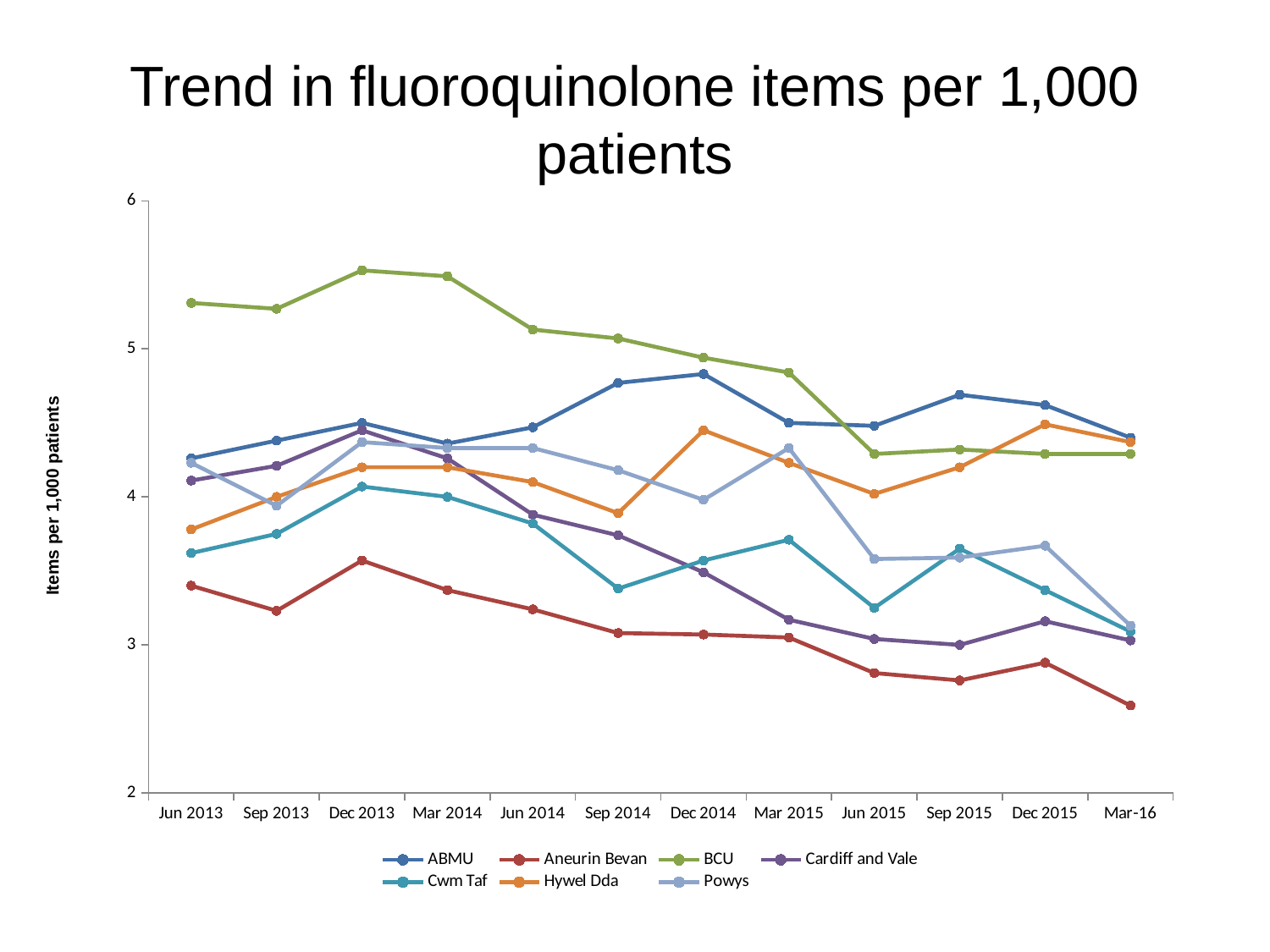
Does the BCU series rise or fall overall from Jun 2013 to Mar-16? fall How many time points are shown along the x axis? 12 How many series does the legend list? 7 Which series has the lowest value at Mar-16? Aneurin Bevan What kind of chart is shown on the slide? line chart Is the value for BCU at Dec 2013 greater or less than 5? greater At Mar 2015, which is larger: the value for ABMU or the value for Cwm Taf? ABMU Is the value for Powys at Mar-16 greater or less than 4? less Is the value for Aneurin Bevan at Mar-16 greater or less than 3? less Which series has the highest value at Jun 2013? BCU What is the title of the y axis? Items per 1,000 patients Which series has the highest value at Sep 2015? ABMU